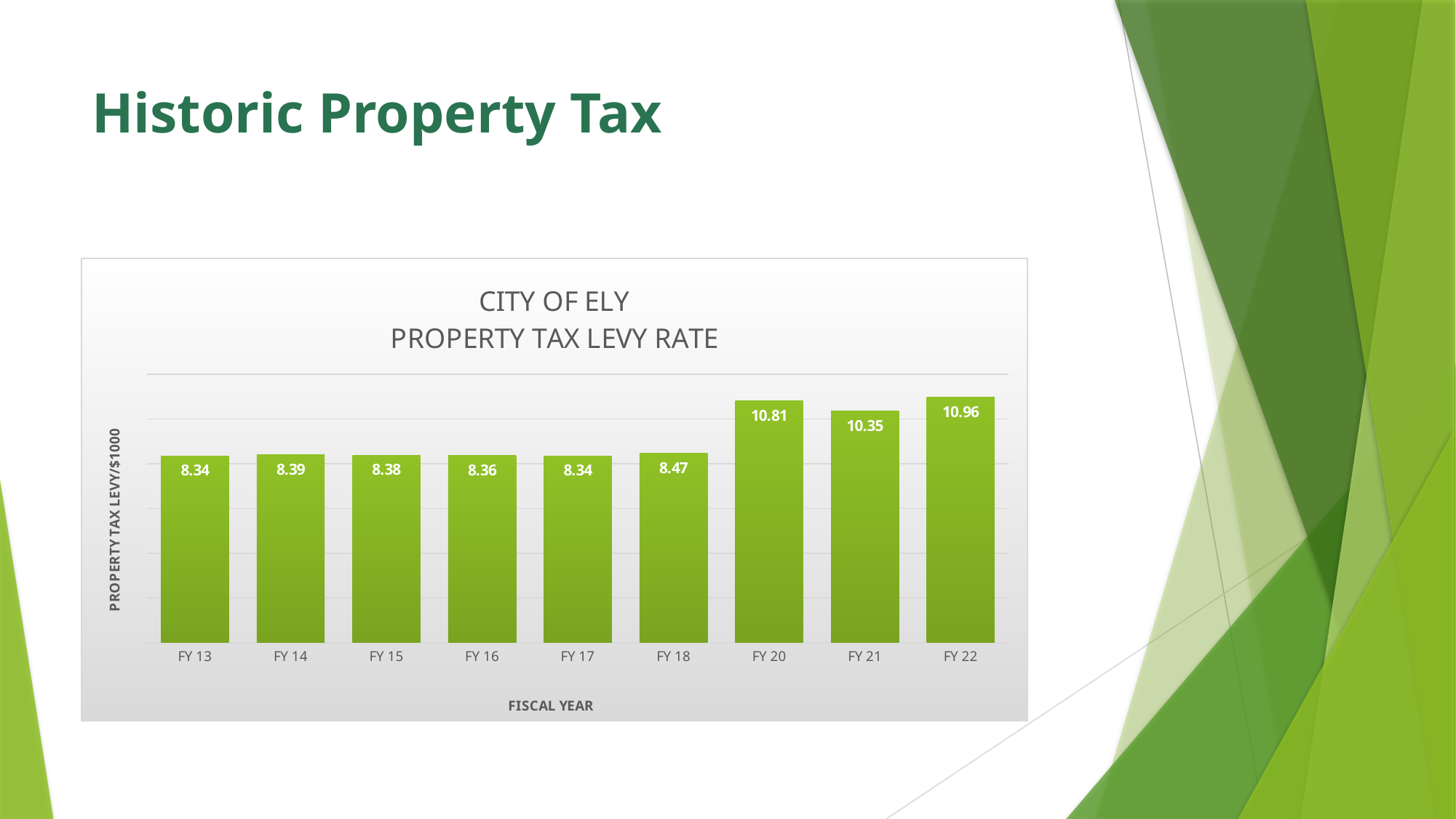
What is the property tax levy rate for FY 20? 10.81 What is the title of the chart? CITY OF ELY PROPERTY TAX LEVY RATE What is the label of the vertical axis? PROPERTY TAX LEVY/$1000 What is the difference between the levy rate in FY 20 and FY 18? 2.34 How many fiscal years are shown on the chart? 9 Do the levy rates generally rise or fall from FY 13 to FY 22? Rise What kind of chart is shown on the slide? Bar chart What is the property tax levy rate for FY 14? 8.39 Which is larger, the levy rate for FY 20 or FY 21? FY 20 Which fiscal year has the highest property tax levy rate? FY 22 What is the difference between the levy rate in FY 22 and FY 21? 0.61 What is the property tax levy rate for FY 18? 8.47